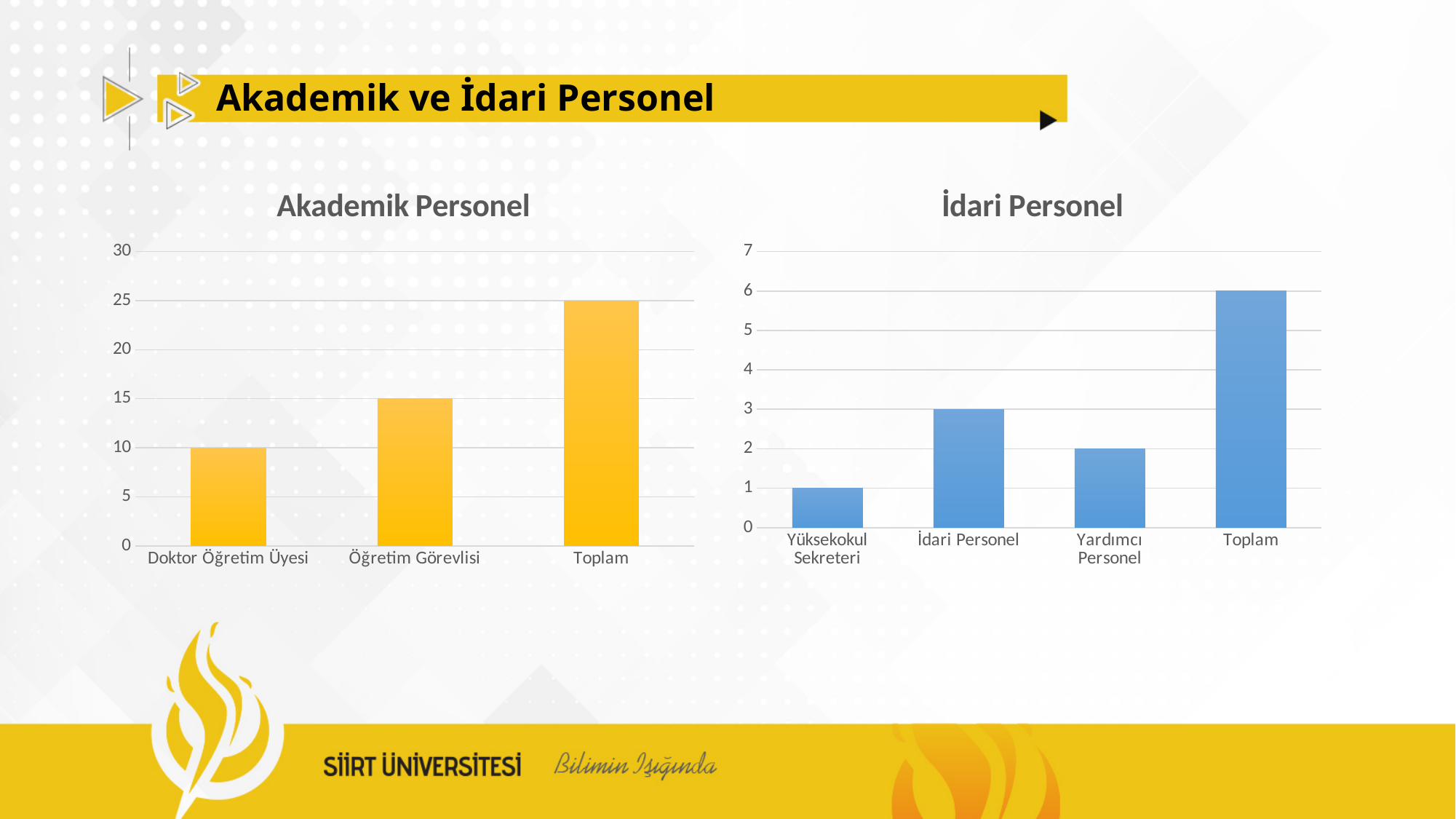
What kind of chart is the Akademik Personel chart? Bar chart In the İdari Personel chart, what is the value for Yüksekokul Sekreteri? 1 In the İdari Personel chart, what is the value for Toplam? 6 In the Akademik Personel chart, what is the difference between Öğretim Görevlisi and Doktor Öğretim Üyesi? 5 In the Akademik Personel chart, which category has the lowest value? Doktor Öğretim Üyesi In the Akademik Personel chart, what is the value for Doktor Öğretim Üyesi? 10 What colour are the bars in the İdari Personel chart? Blue In the İdari Personel chart, which is larger, İdari Personel or Yardımcı Personel? İdari Personel In the İdari Personel chart, how many categories are shown on the x axis? 4 In the Akademik Personel chart, what is the value for Toplam? 25 In the İdari Personel chart, what is the value for İdari Personel? 3 In the Akademik Personel chart, what is the value for Öğretim Görevlisi? 15